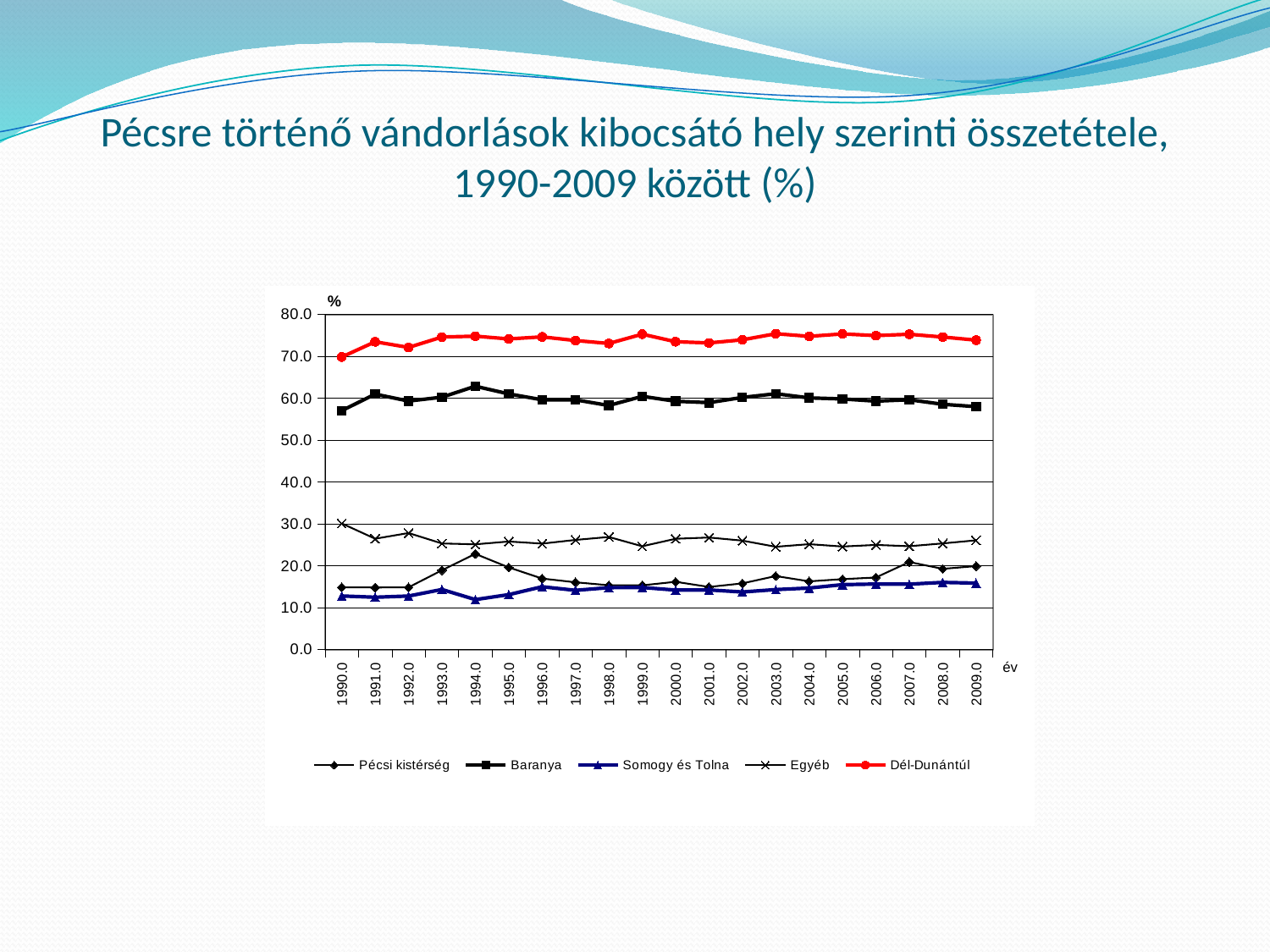
Which series has the lowest value in 1994? Somogy és Tolna Is the value for Dél-Dunántúl in 1999 greater or less than 70.0? greater Is the value for Baranya in 1990 greater or less than 60.0? less How many years are plotted along the x axis? 20 What kind of chart is shown on the slide? line chart Which series has the highest values throughout the whole period? Dél-Dunántúl How many series does the legend list? 5 Which series is drawn in red in the chart? Dél-Dunántúl In 2000, which is larger: the value for Baranya or the value for Egyéb? Baranya Is the value for Egyéb in 1993 greater or less than 30.0? less Does the Egyéb series rise or fall between 1990 and 1993? fall